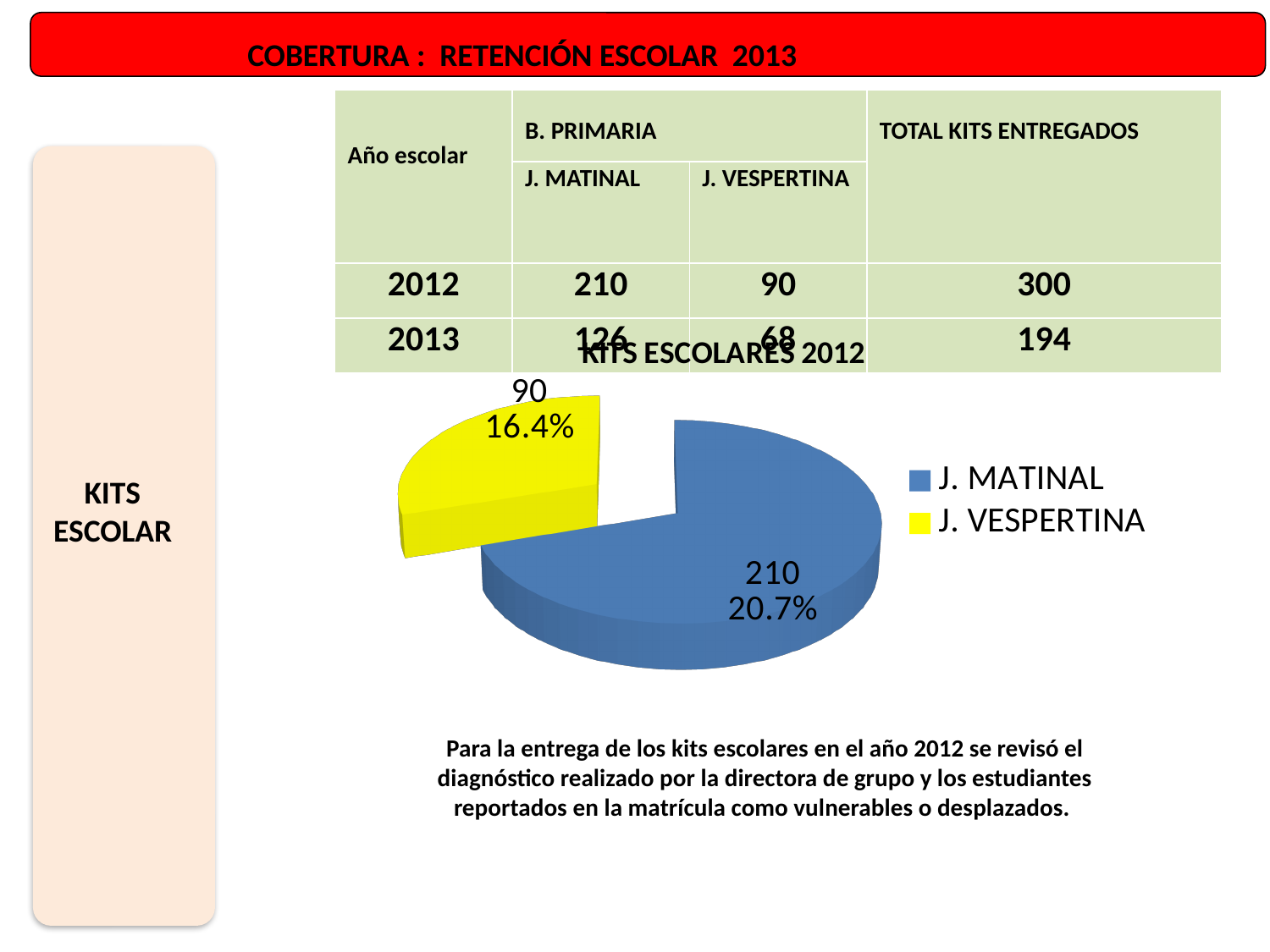
What value is labelled on the J. VESPERTINA slice of the pie chart? 90 Which slice of the pie chart is the smallest? J. VESPERTINA What is the difference between the J. MATINAL and J. VESPERTINA values in the pie chart? 120 What is the title of the pie chart? KITS ESCOLARES 2012 Which is larger in the pie chart, J. MATINAL or J. VESPERTINA? J. MATINAL Which slice of the pie chart is the largest? J. MATINAL What value is labelled on the J. MATINAL slice of the pie chart? 210 What colour is the J. MATINAL slice in the pie chart? Blue How many entries does the legend of the pie chart list? 2 How many slices does the pie chart have? 2 What percentage label is shown on the J. VESPERTINA slice of the pie chart? 16.4% What type of chart is shown on the slide? Pie chart